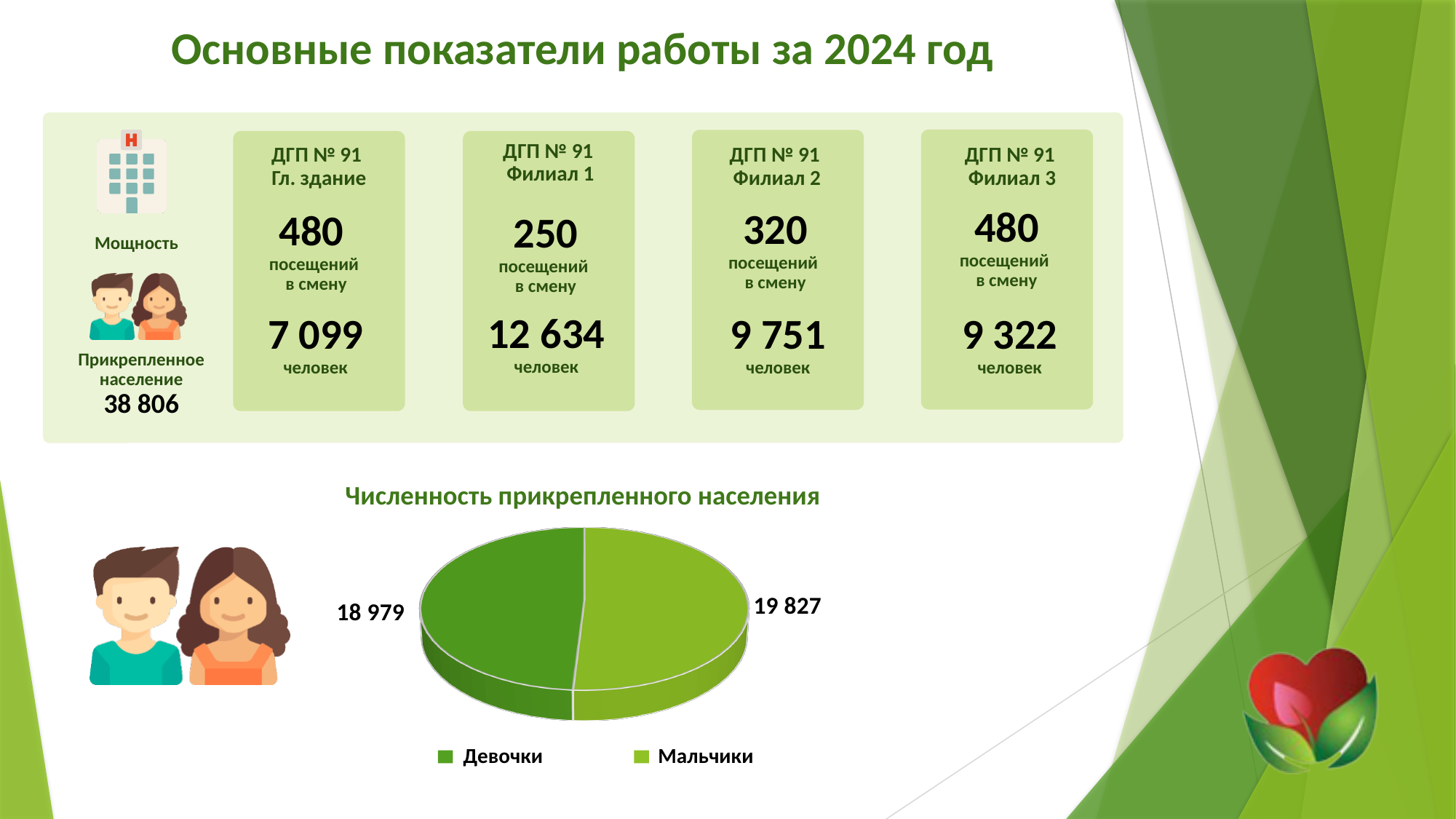
What is the total of the two slices in the pie chart? 38 806 What kind of chart is shown under the heading "Численность прикрепленного населения"? Pie chart What is the difference between the Мальчики and Девочки values in the pie chart? 848 Which slice of the pie chart is the largest? Мальчики Which is larger in the pie chart, Девочки or Мальчики? Мальчики What share of the pie chart does the Мальчики slice represent? 51.1% How many entries does the legend of the pie chart list? 2 Which slice of the pie chart is the smallest? Девочки What is the value for Девочки in the pie chart? 18 979 What is the value for Мальчики in the pie chart? 19 827 What is the title of the pie chart? Численность прикрепленного населения How many slices does the pie chart have? 2